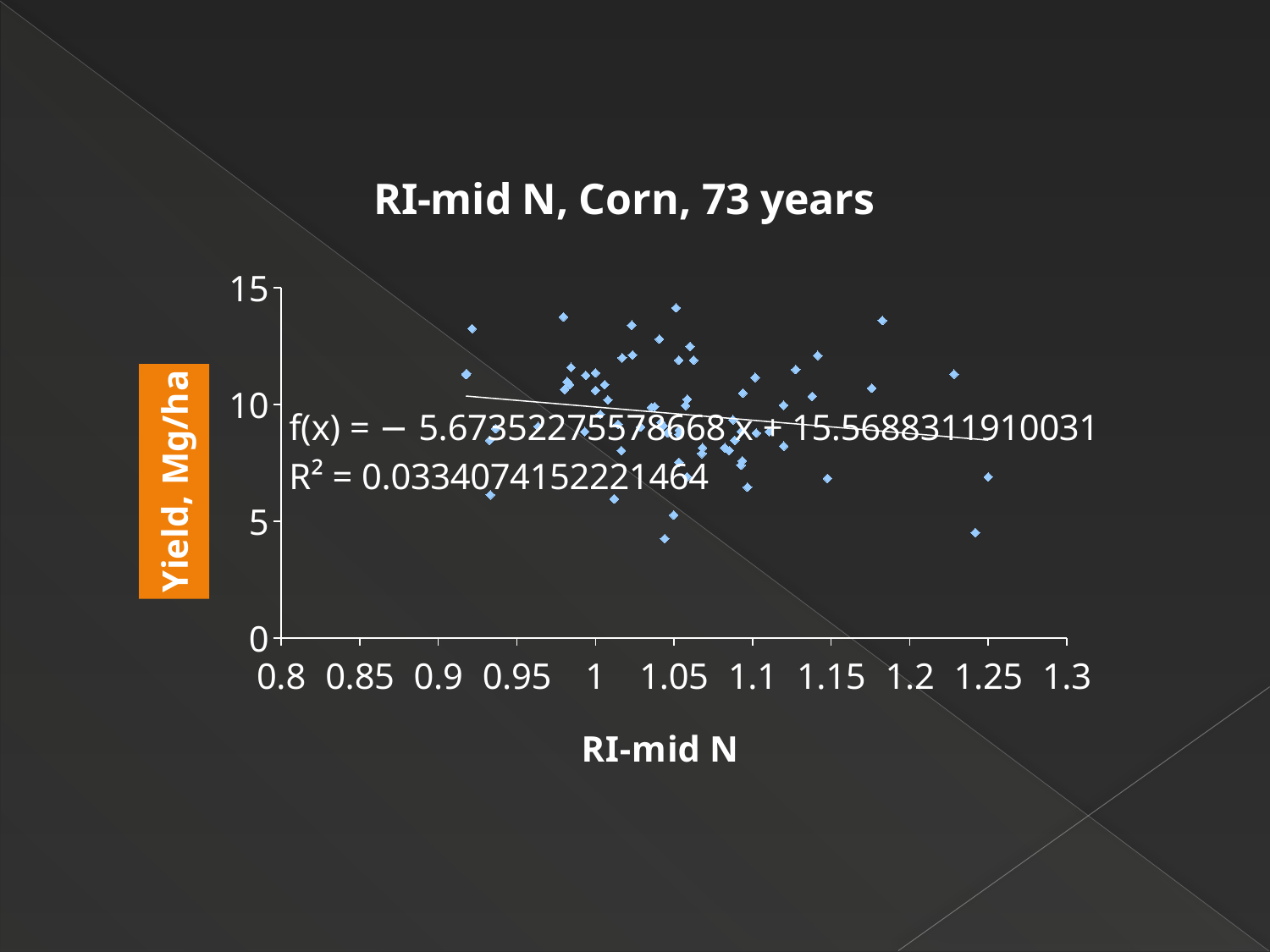
Is the highest yield value plotted greater or less than 10 Mg/ha? greater What kind of chart is shown on the slide? Scatter plot Is the yield of the point at the far right of the chart (near RI-mid N 1.25) greater or less than 10 Mg/ha? less Does the fitted trendline rise or fall as RI-mid N increases? Fall What is the maximum value shown on the y axis? 15 What is the R² value shown on the chart? 0.0334074152221464 Is the lowest yield value plotted greater or less than 5 Mg/ha? less What is the intercept of the fitted line f(x) shown on the chart? 15.5688311910031 What is the title of the chart? RI-mid N, Corn, 73 years What is the slope of the fitted line f(x) shown on the chart? −5.67352275578668 What is the label of the y axis? Yield, Mg/ha